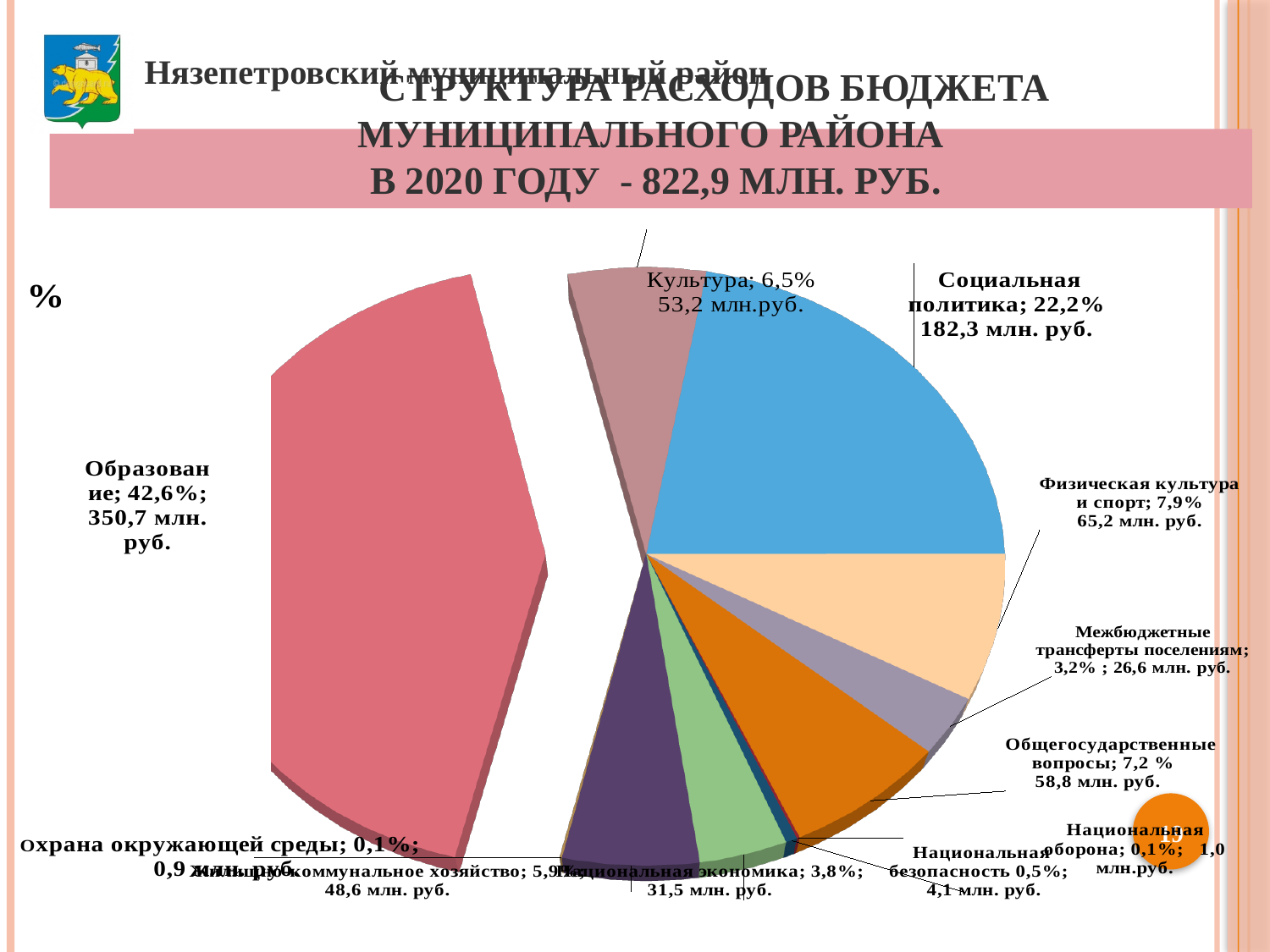
What percentage share does Культура have in the pie chart? 6,5% What is the amount in million rubles for Социальная политика? 182,3 млн. руб. Which is larger: Общегосударственные вопросы or Межбюджетные трансферты поселениям? Общегосударственные вопросы What total budget expenditure for 2020 is stated in the chart title? 822,9 млн. руб. What is the amount for Национальная экономика? 31,5 млн. руб. What is the difference in million rubles between Образование and Социальная политика? 168,4 млн. руб. What kind of chart is shown on the slide? pie chart Which category has the largest share of the budget expenditure? Образование What share of the budget expenditure does Образование (education) account for? 42,6% What is the amount for Межбюджетные трансферты поселениям? 26,6 млн. руб. What is the amount for Физическая культура и спорт? 65,2 млн. руб. What percentage share does Национальная безопасность have? 0,5%